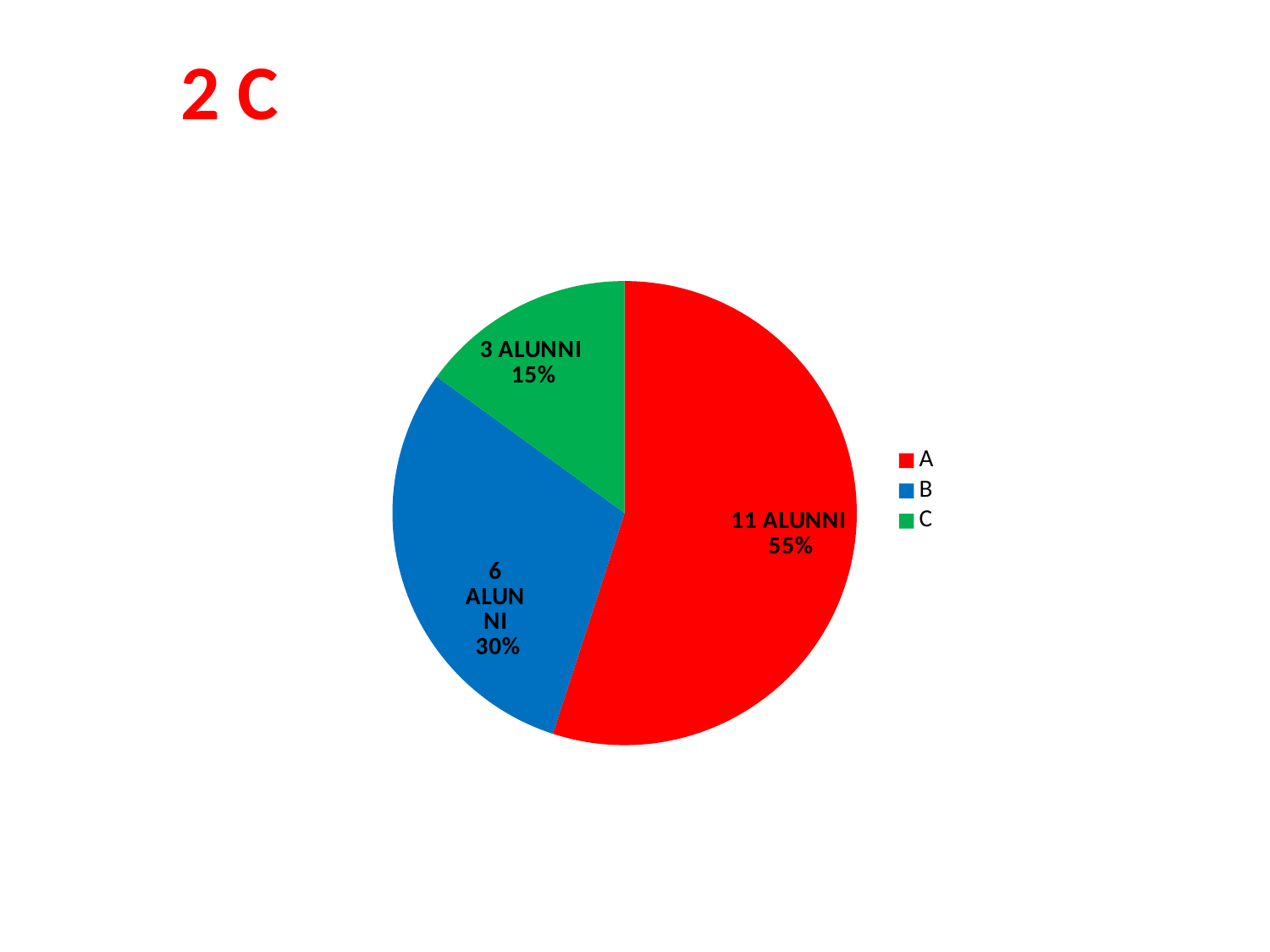
How many alunni are in category B? 6 ALUNNI What percentage share does slice C have? 15% Which category has the smallest slice? C Which category has the largest slice? A How many alunni are in category A? 11 ALUNNI What percentage share does slice A have? 55% Which colour represents category C in the legend? green What kind of chart is shown on the slide? pie chart How many slices does the pie chart have? 3 What is the difference in percentage points between slice A and slice B? 25% What percentage share does slice B have? 30% How many entries does the legend list? 3